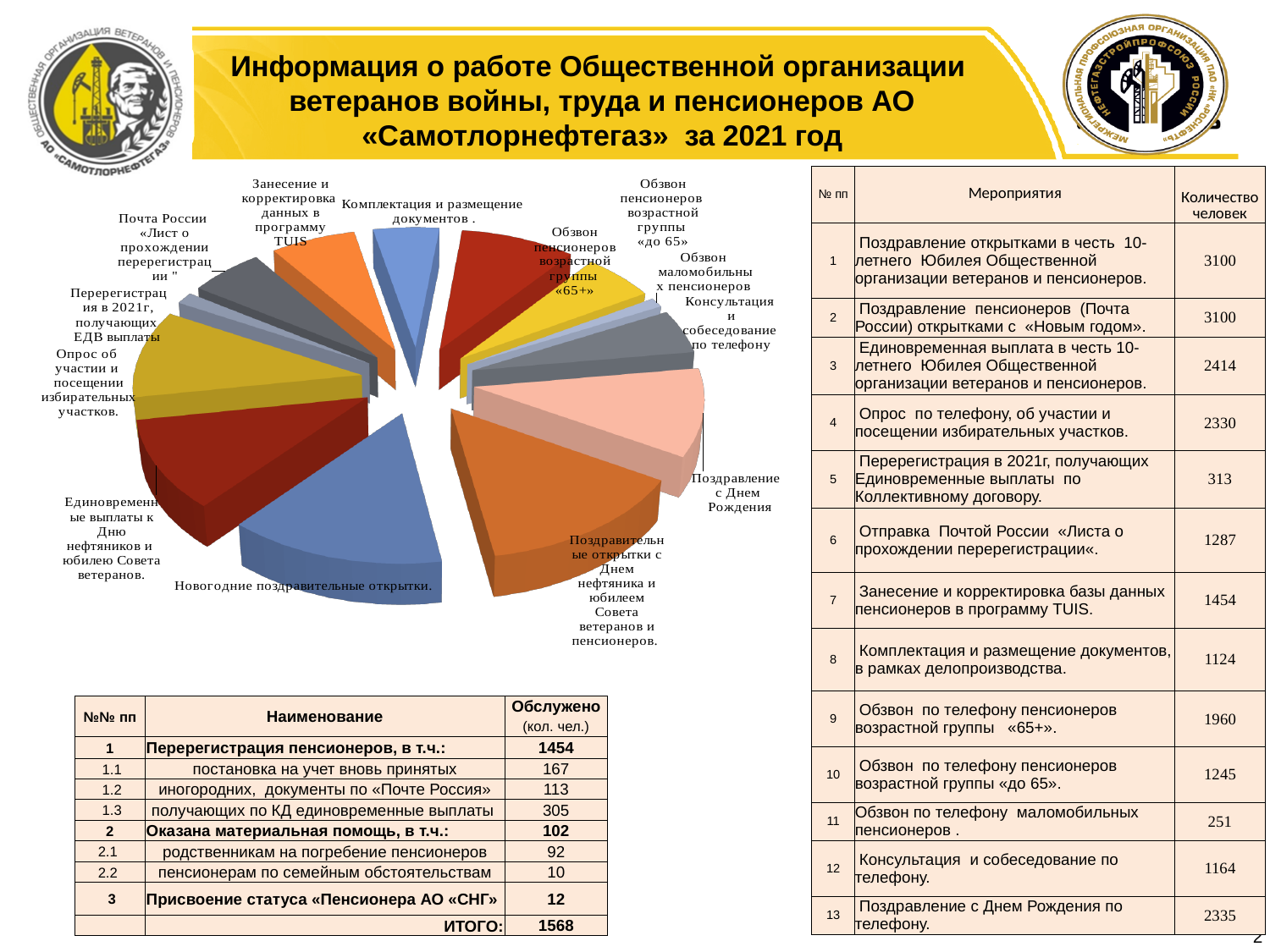
In the pie chart, which slice is larger: «Опрос об участии и посещении избирательных участков» or «Обзвон маломобильных пенсионеров»? Опрос об участии и посещении избирательных участков How many slices does the pie chart have? 13 What kind of chart is shown on the slide? pie chart In the pie chart, which slice is larger: «Единовременные выплаты к Дню нефтяников и юбилею Совета ветеранов» or «Перерегистрация в 2021г, получающих ЕДВ выплаты»? Единовременные выплаты к Дню нефтяников и юбилею Совета ветеранов Is the pie chart drawn in 3D or flat 2D? 3D Does the pie chart display numeric data labels on its slices? No In the pie chart, which slice is larger: «Поздравление с Днем Рождения» or «Консультация и собеседование по телефону»? Поздравление с Днем Рождения